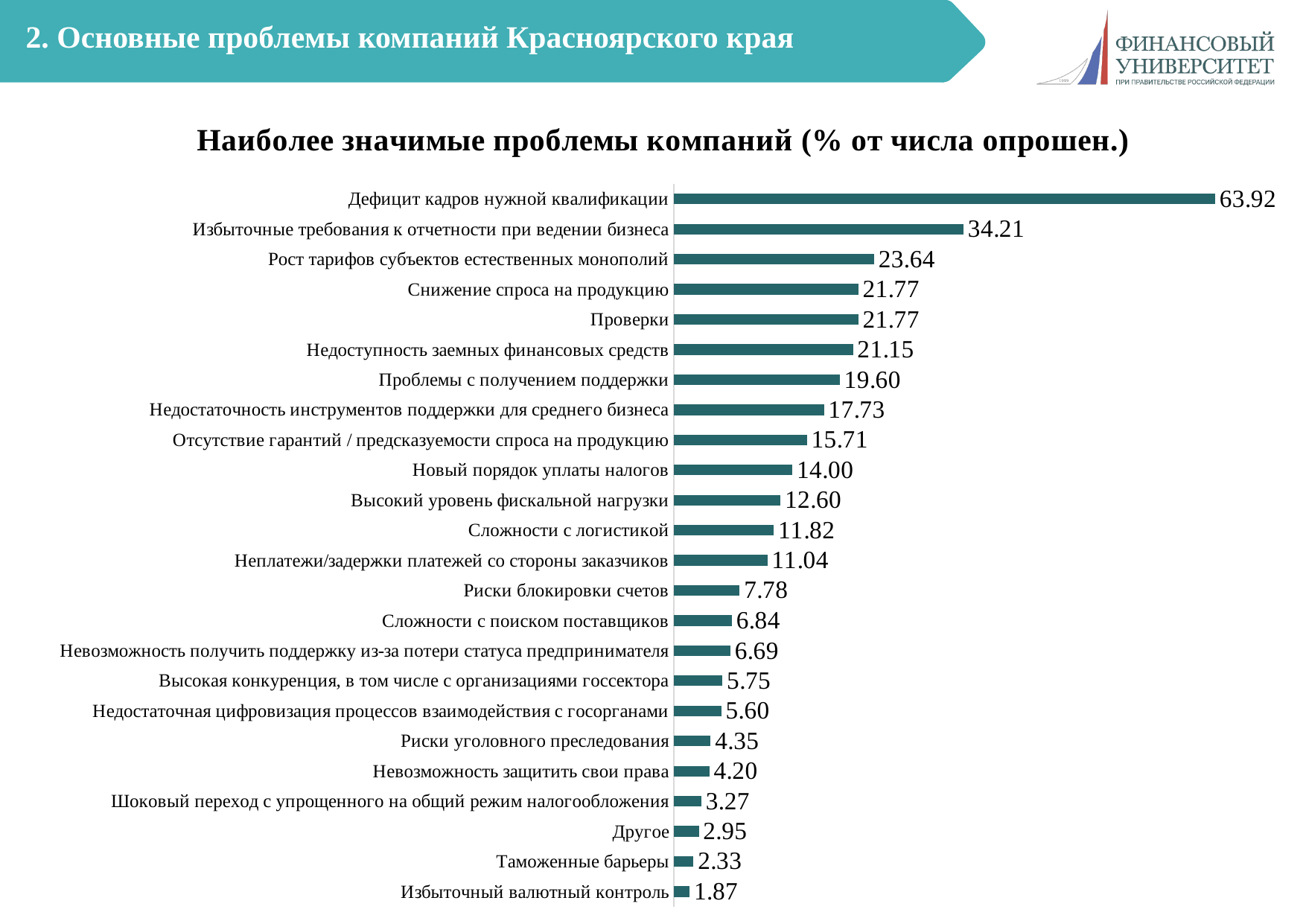
What is the difference between «Дефицит кадров нужной квалификации» and «Избыточные требования к отчетности при ведении бизнеса»? 29.71 Which category has the highest value? Дефицит кадров нужной квалификации What kind of chart is shown on the slide? Bar chart Which is larger: «Риски блокировки счетов» or «Сложности с поиском поставщиков»? Риски блокировки счетов Which category has the lowest value? Избыточный валютный контроль What is the value for «Дефицит кадров нужной квалификации»? 63.92 What is the value for «Таможенные барьеры»? 2.33 What is the title of the chart? Наиболее значимые проблемы компаний (% от числа опрошен.) What is the value for «Сложности с логистикой»? 11.82 Which is larger: «Рост тарифов субъектов естественных монополий» or «Недоступность заемных финансовых средств»? Рост тарифов субъектов естественных монополий How many categories are shown in the chart? 24 What is the difference between «Новый порядок уплаты налогов» and «Высокий уровень фискальной нагрузки»? 1.40